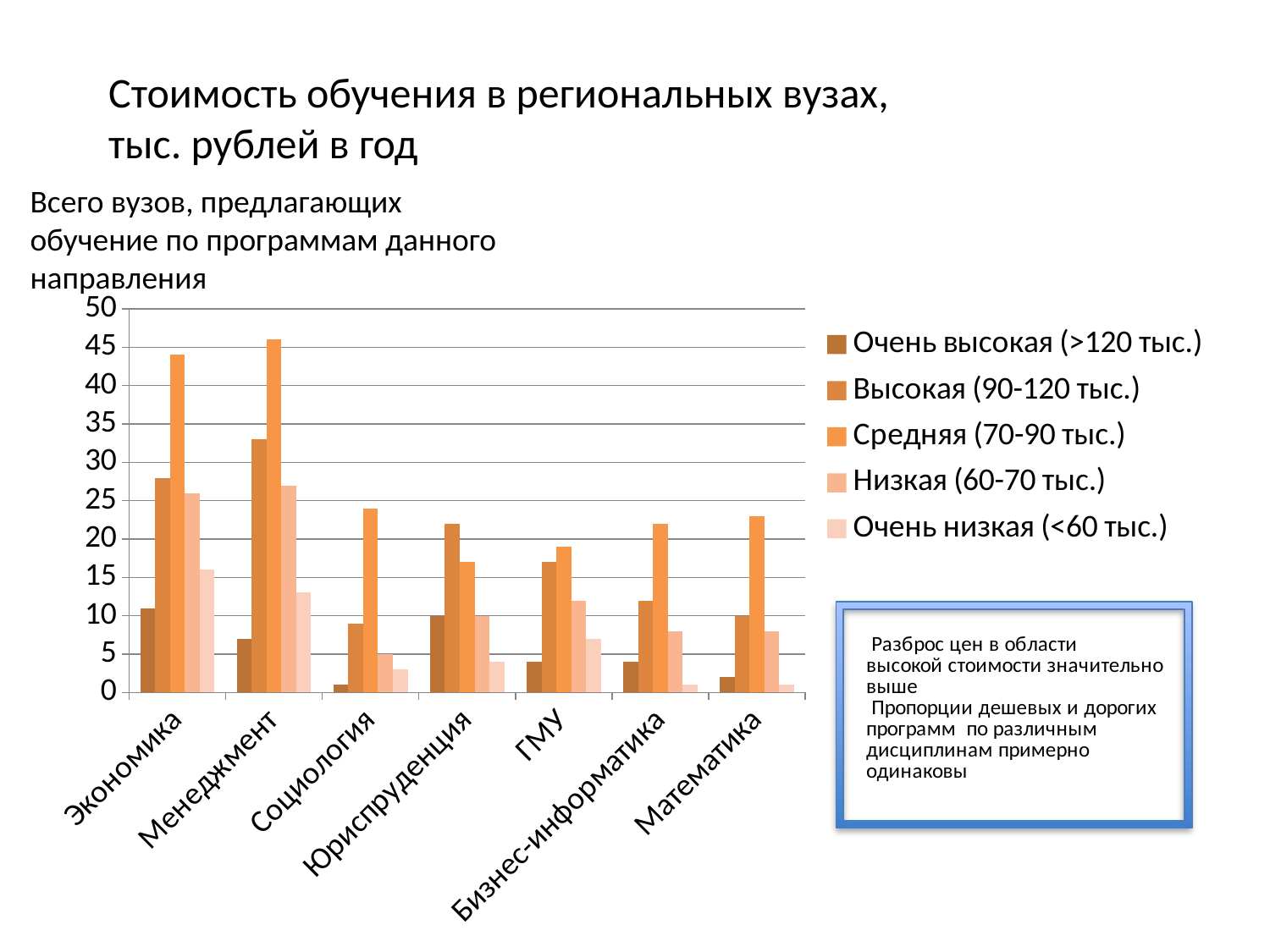
Which legend entry is shown with the darkest brown colour? Очень высокая (>120 тыс.) What kind of chart is shown on the slide? Bar chart Which is larger: the "Низкая (60-70 тыс.)" value for Экономика or for Социология? Экономика Is the value for "Очень низкая (<60 тыс.)" in Математика greater or less than 5? less How many categories (directions of study) are shown on the x axis? 7 Which is larger: the "Очень низкая (<60 тыс.)" value for Экономика or for Менеджмент? Экономика Which category has the highest bar for the series "Высокая (90-120 тыс.)"? Менеджмент Is the value for "Средняя (70-90 тыс.)" in Экономика greater or less than 40? greater Is the value for "Высокая (90-120 тыс.)" in Менеджмент greater or less than 30? greater How many series does the legend list? 5 What is the title of the chart? Стоимость обучения в региональных вузах, тыс. рублей в год